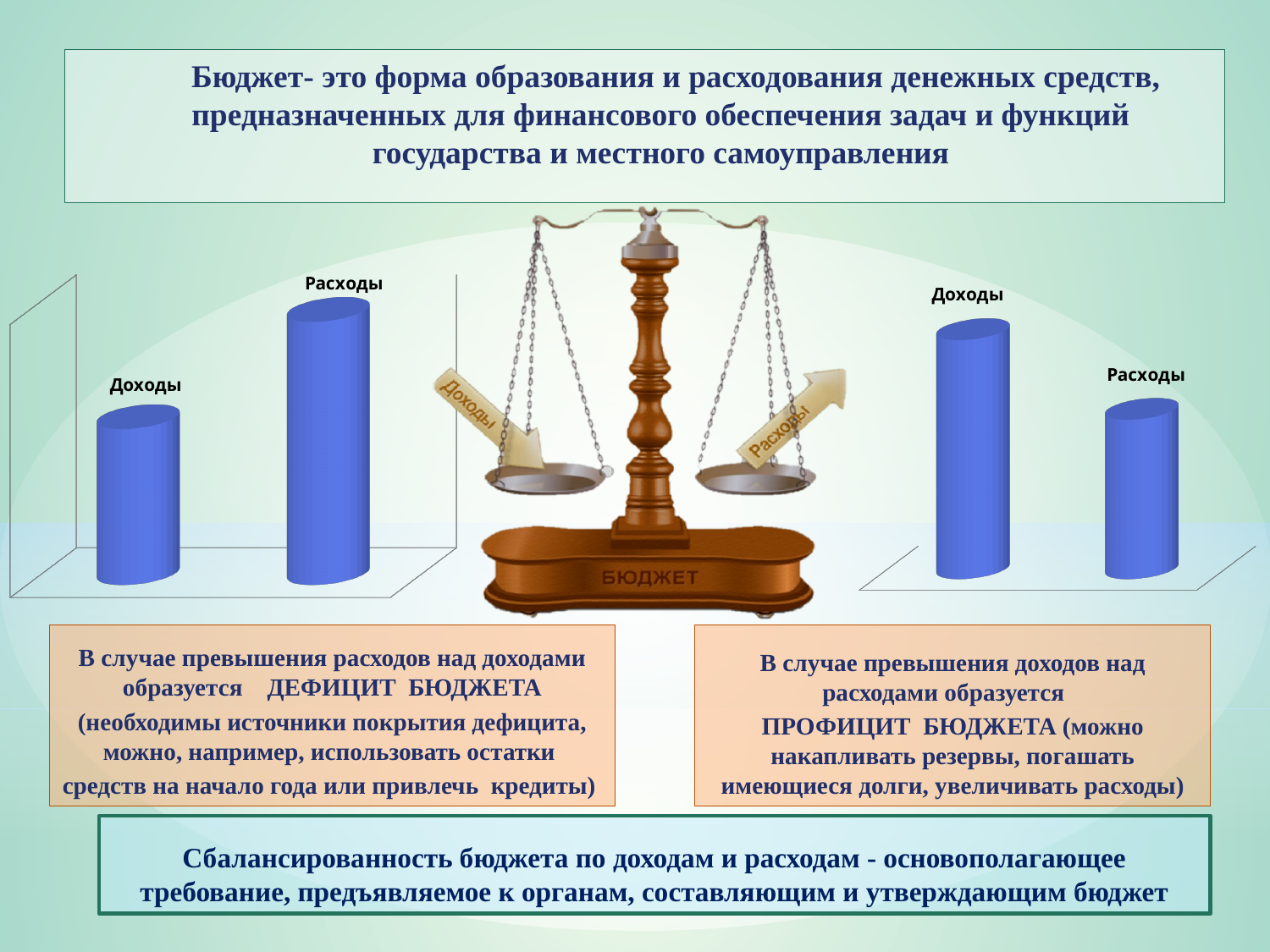
In the left chart, how many bars are plotted? 2 In the left chart, which category has the shorter bar? Доходы In the right chart, which category has the taller bar? Доходы What kind of chart is shown on the left side of the slide? bar chart What colour are the bars in both charts? blue In the right chart, how many bars are plotted? 2 In the left chart, which category has the taller bar? Расходы What are the two category labels shown in the left chart? Доходы and Расходы In the left chart, is the bar for Доходы taller or shorter than the bar for Расходы? shorter What kind of chart is shown on the right side of the slide? bar chart In the right chart, is the bar for Расходы taller or shorter than the bar for Доходы? shorter In the right chart, which category has the shorter bar? Расходы